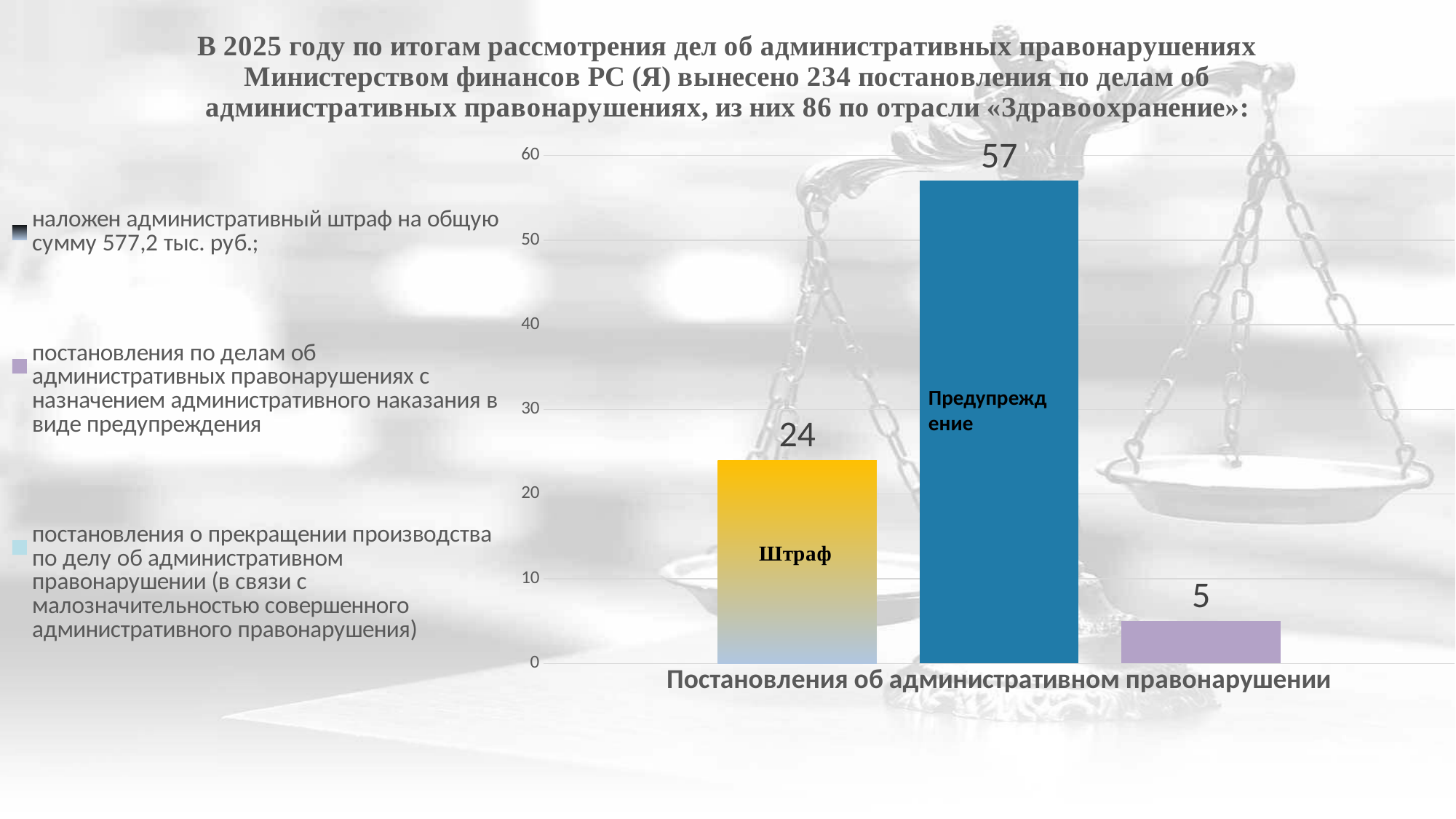
Which is larger, the Штраф bar or the Предупреждение bar? Предупреждение Which bar has the lowest value? The rightmost (purple) bar, 5 How many entries does the legend list? 3 Which bar has the highest value? Предупреждение What is the value of the Предупреждение bar? 57 What is the value of the Штраф bar? 24 What is the difference between the Предупреждение bar and the Штраф bar? 33 What kind of chart is shown on the slide? Bar chart What is the total of the three bar values? 86 How many bars are plotted in the chart? 3 What is the label shown under the x axis of the chart? Постановления об административном правонарушении What is the value of the rightmost (purple) bar? 5